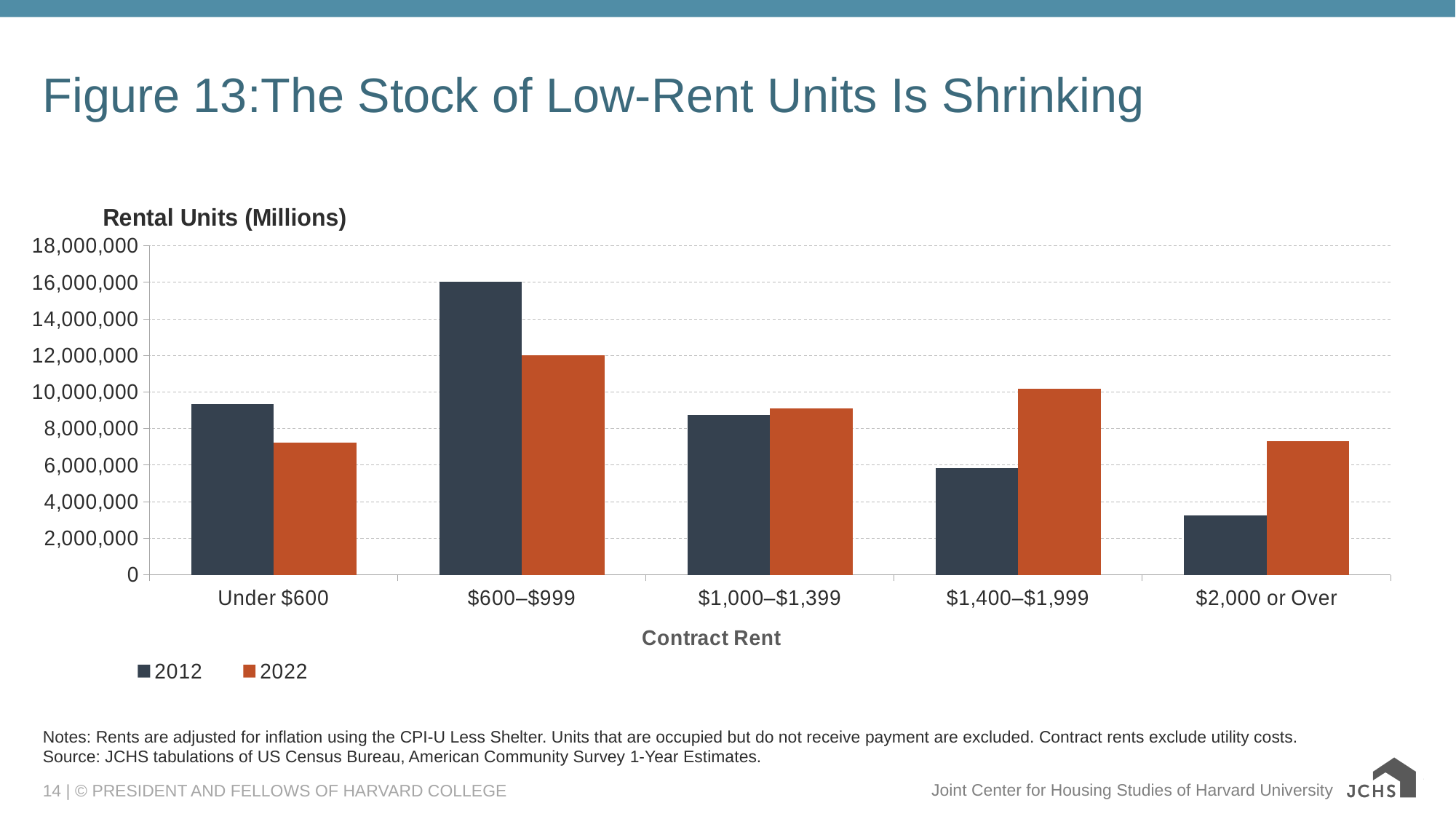
Is the 2012 value for $2,000 or Over greater or less than 4,000,000? less Moving from $600–$999 to $2,000 or Over, do the 2012 values rise or fall? fall For the $2,000 or Over category, which year has more rental units, 2012 or 2022? 2022 What kind of chart is shown on the slide? Bar chart How many contract rent categories are shown on the x axis? 5 Which contract rent category has the highest number of rental units in 2012? $600–$999 For the Under $600 category, which year has more rental units, 2012 or 2022? 2012 Which contract rent category has the highest number of rental units in 2022? $600–$999 Is the 2012 value for $600–$999 greater or less than 14,000,000? greater Which contract rent category has the lowest number of rental units in 2012? $2,000 or Over Is the 2022 value for $1,400–$1,999 greater or less than 8,000,000? greater How many series does the legend list? 2